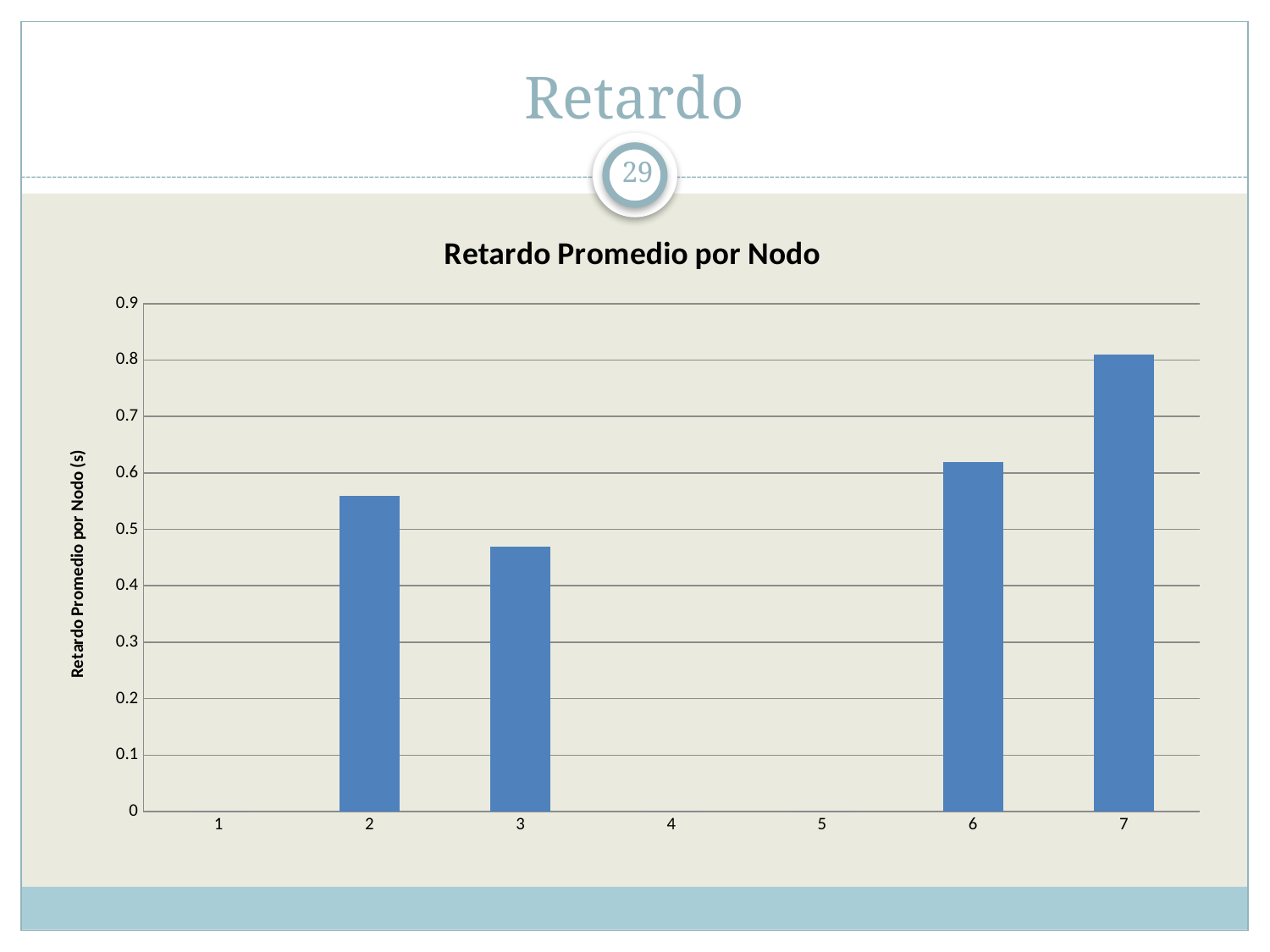
How many node categories are shown on the x axis? 7 Which has the larger value, node 6 or node 7? Node 7 Is the value for node 7 greater or less than 0.7? greater What kind of chart is shown on the slide? Bar chart Among the nodes with a visible bar, which node has the shortest bar? 3 What is the label of the vertical axis? Retardo Promedio por Nodo (s) How many nodes have a visible bar in the chart? 4 Is the value for node 3 greater or less than 0.5? less Which has the larger value, node 2 or node 3? Node 2 What is the title of the chart? Retardo Promedio por Nodo Is the value for node 2 greater or less than 0.5? greater Which node has the tallest bar? 7